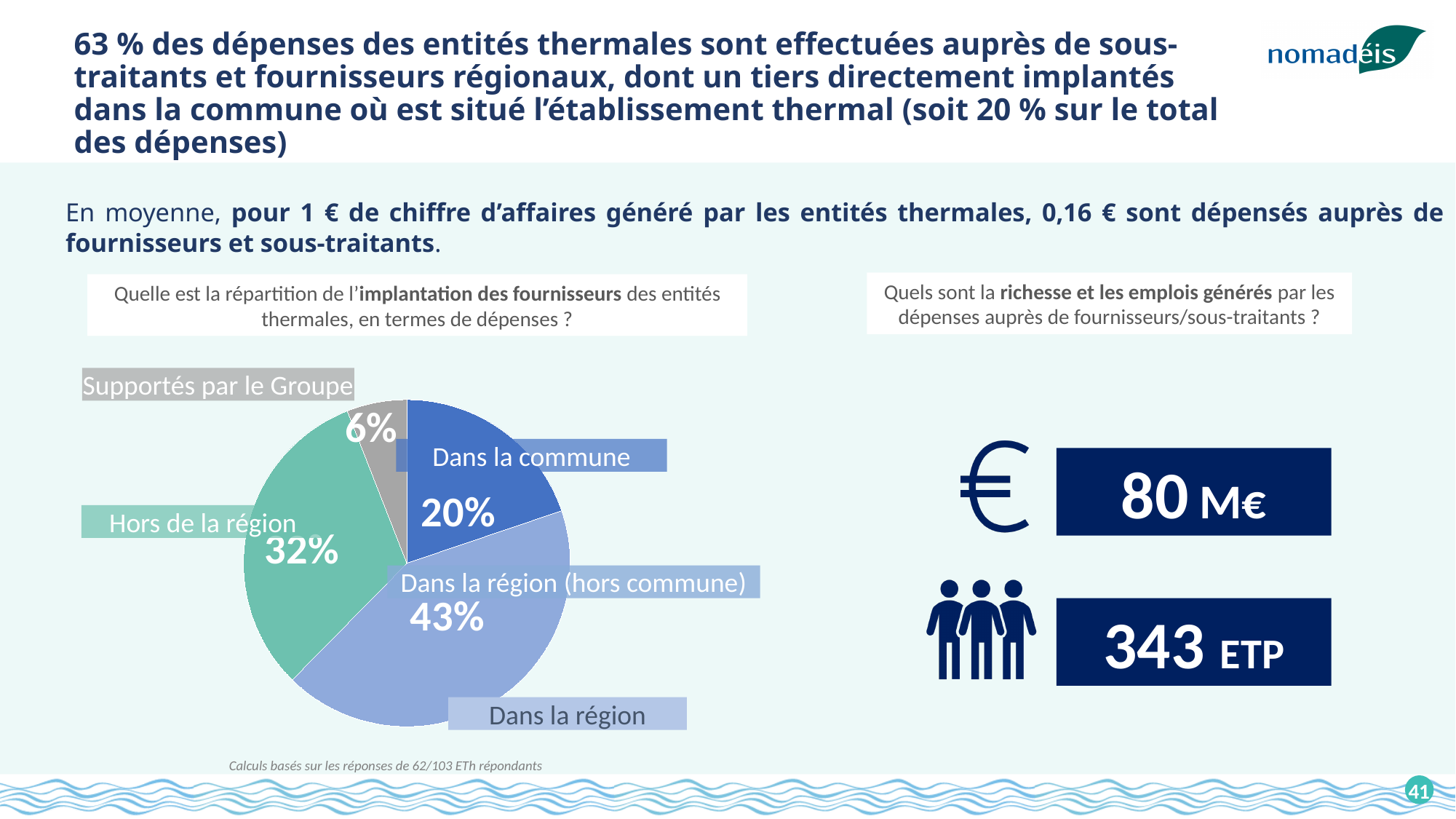
What share of spending is labelled "Hors de la région" in the pie chart? 32% What kind of chart is shown on the slide? pie chart What share of spending is labelled "Dans la commune" in the pie chart? 20% What is the combined share of the "Dans la commune" and "Dans la région (hors commune)" slices? 63% What is the difference in percentage points between the "Dans la région (hors commune)" slice and the "Hors de la région" slice? 11 percentage points What share of spending is labelled "Dans la région (hors commune)" in the pie chart? 43% What share of spending is labelled "Supportés par le Groupe" in the pie chart? 6% What colour is the "Hors de la région" slice of the pie chart? green How many slices does the pie chart have? 4 Which is larger in the pie chart: "Hors de la région" or "Dans la commune"? Hors de la région Which slice of the pie chart is the smallest? Supportés par le Groupe Which slice of the pie chart is the largest? Dans la région (hors commune)